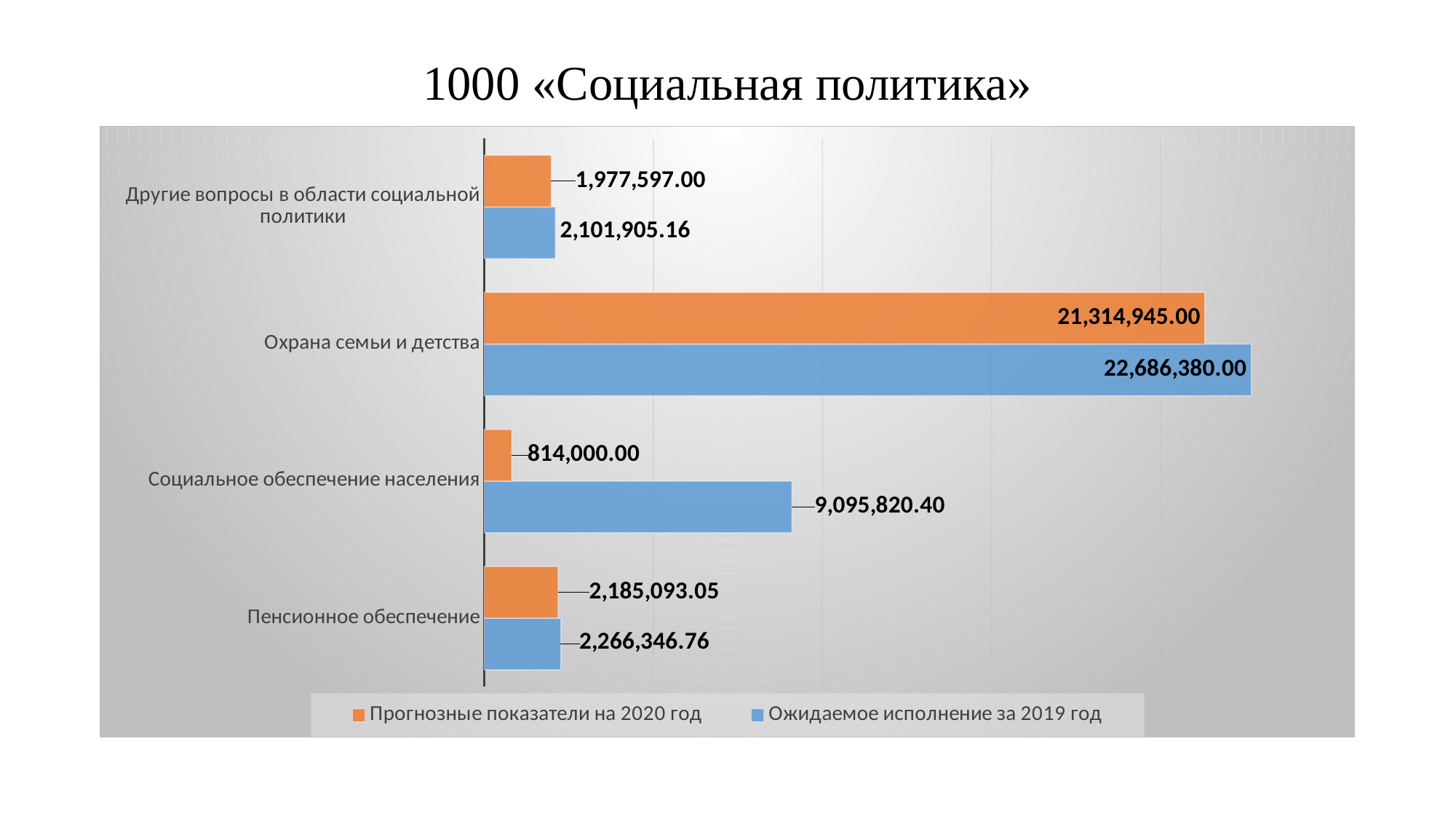
Which category has the lowest value for 'Прогнозные показатели на 2020 год'? Социальное обеспечение населения What is the title of the chart on the slide? 1000 «Социальная политика» What is the value of 'Ожидаемое исполнение за 2019 год' for 'Пенсионное обеспечение'? 2,266,346.76 What is the difference between 'Ожидаемое исполнение за 2019 год' and 'Прогнозные показатели на 2020 год' for 'Социальное обеспечение населения'? 8,281,820.40 What type of chart is shown on the slide? bar chart What is the difference between 'Ожидаемое исполнение за 2019 год' and 'Прогнозные показатели на 2020 год' for 'Охрана семьи и детства'? 1,371,435.00 Which category has the highest value for 'Прогнозные показатели на 2020 год'? Охрана семьи и детства For 'Другие вопросы в области социальной политики', which is larger: 'Прогнозные показатели на 2020 год' or 'Ожидаемое исполнение за 2019 год'? Ожидаемое исполнение за 2019 год How many categories are shown on the chart? 4 What is the value of 'Ожидаемое исполнение за 2019 год' for 'Социальное обеспечение населения'? 9,095,820.40 What is the value of 'Прогнозные показатели на 2020 год' for 'Охрана семьи и детства'? 21,314,945.00 How many series does the legend list? 2